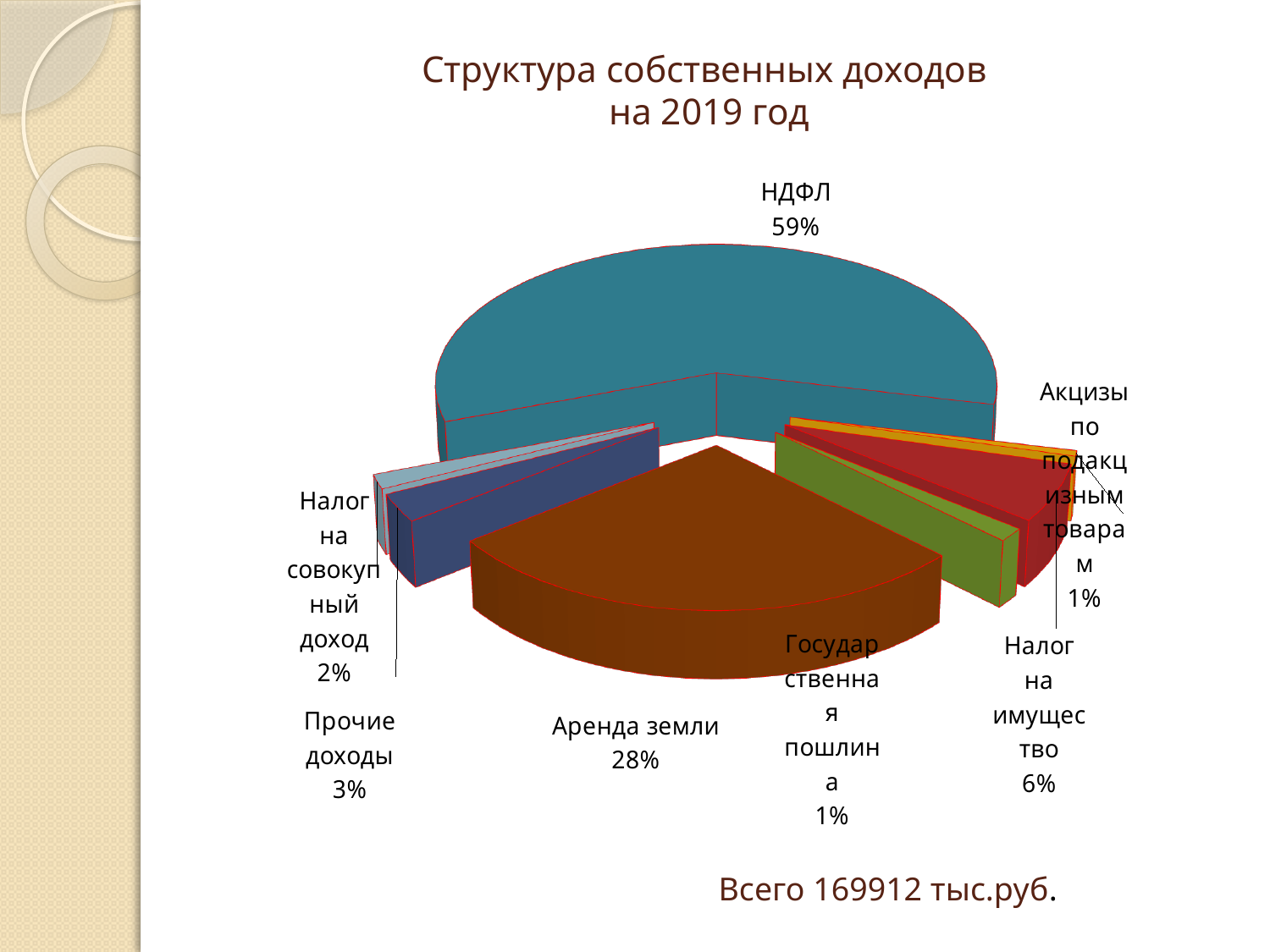
Which category has the largest share of the pie? НДФЛ How many categories are shown in the pie chart? 7 What kind of chart is shown on the slide? Pie chart What percentage is shown for Прочие доходы? 3% What percentage is shown for Налог на имущество? 6% What percentage is shown for Налог на совокупный доход? 2% What is the difference in percentage points between НДФЛ and Аренда земли? 31 What percentage is shown for Аренда земли? 28% What share of own revenues does НДФЛ account for? 59% What total amount is stated below the chart? 169912 тыс.руб. What is the title of the chart? Структура собственных доходов на 2019 год Which is larger, the share for Аренда земли or the share for Налог на имущество? Аренда земли